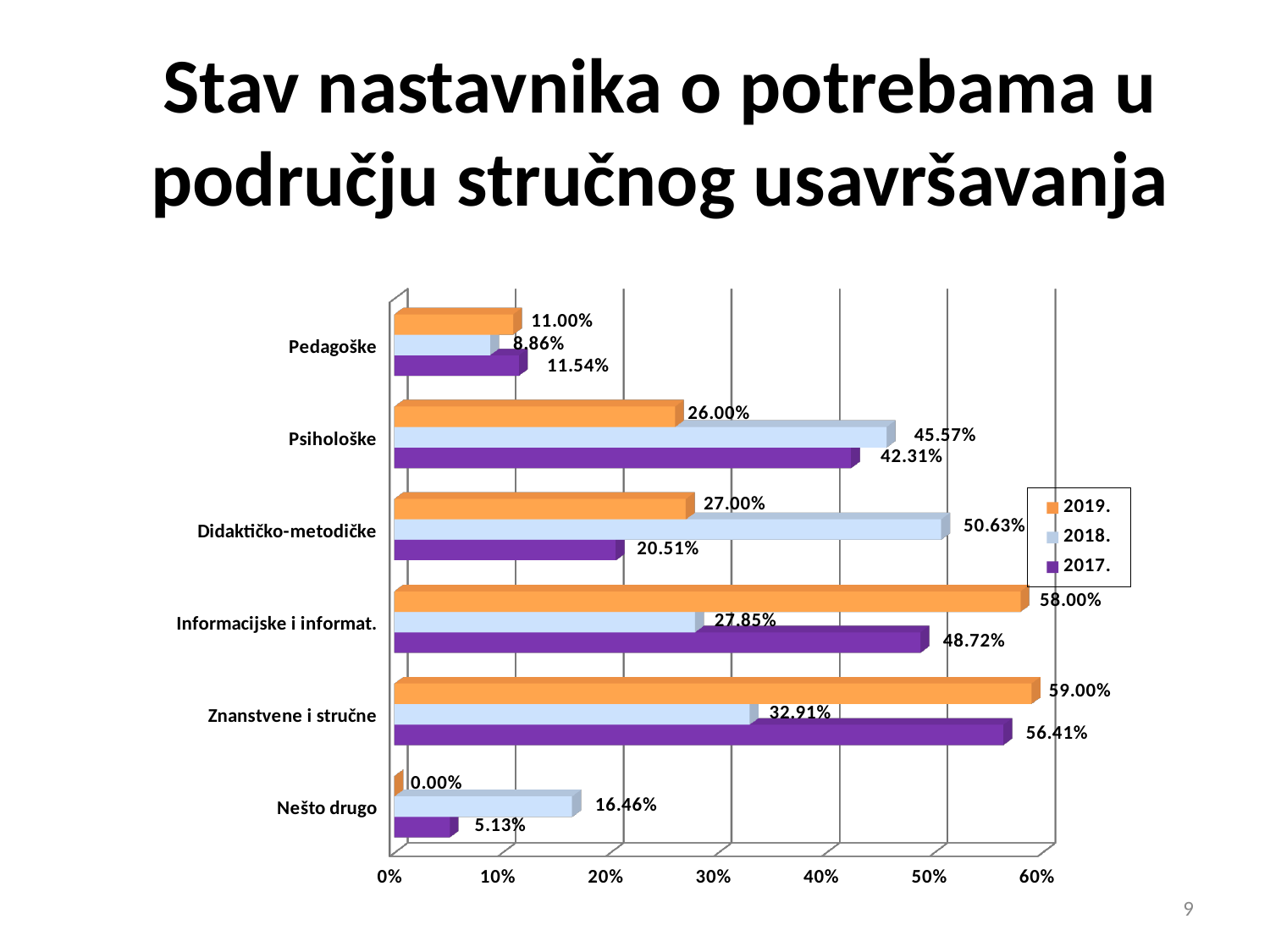
Which is larger for Psihološke: the 2018. value or the 2017. value? 2018. Which series is shown in purple? 2017. How many categories are shown on the chart? 6 What kind of chart is shown on the slide? bar chart Which category has the highest value in the 2019. series? Znanstvene i stručne What is the value for Psihološke in the 2018. series? 45.57% Is the value for Znanstvene i stručne in the 2017. series greater or less than 50%? greater Which category has the lowest value in the 2018. series? Pedagoške What is the value for Informacijske i informat. in the 2019. series? 58.00% How many series does the legend list? 3 What is the difference between the 2018. and 2019. values for Didaktičko-metodičke? 23.63% What is the value for Nešto drugo in the 2017. series? 5.13%